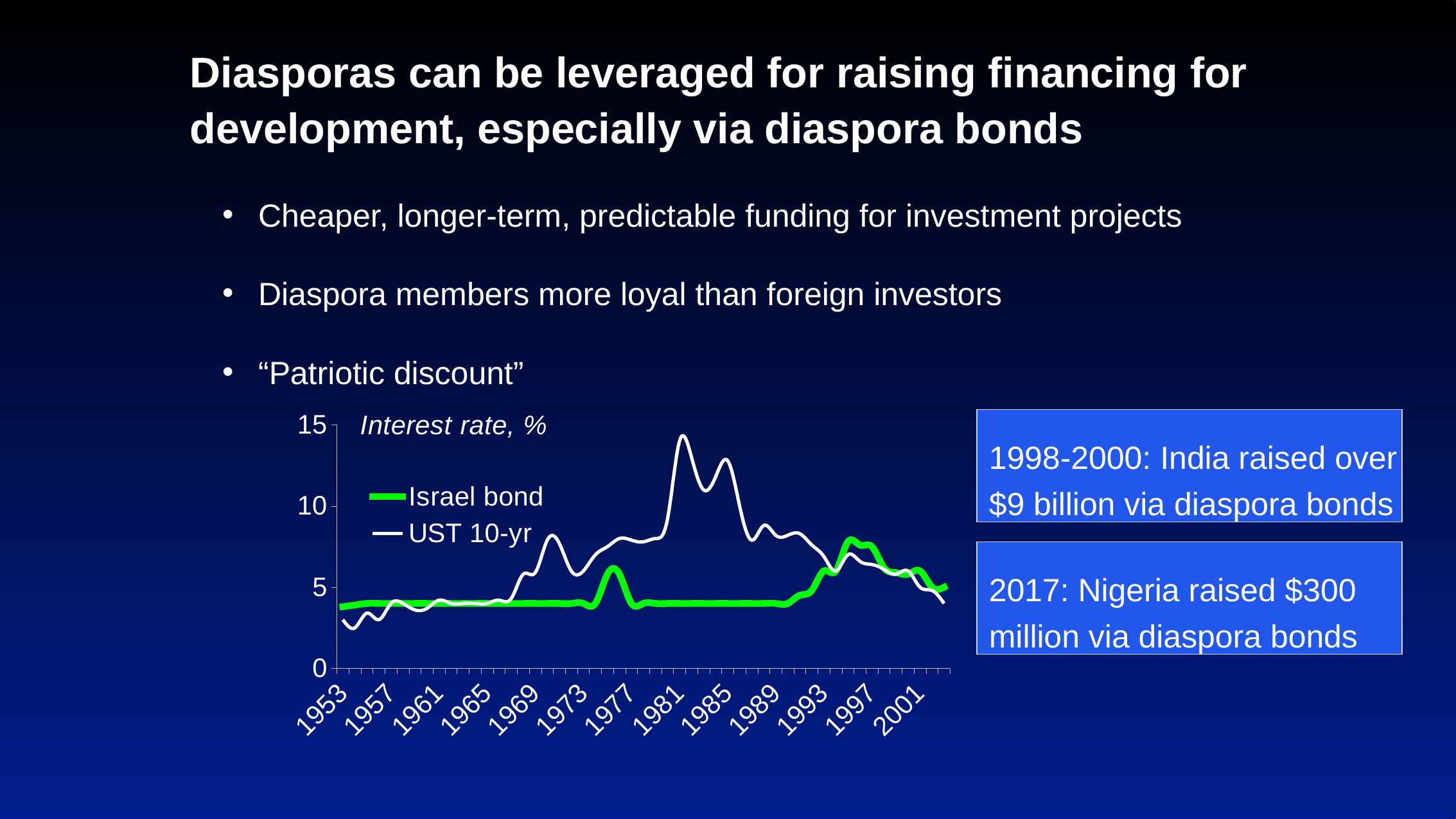
How many year labels are shown on the chart's x axis? 13 What kind of chart is shown on the slide? line chart What is the label on the chart's vertical axis? Interest rate, % How many series does the chart's legend list? 2 Is the Israel bond value around 1981 greater or less than 5? less Around 1985, which series has the higher interest rate, Israel bond or UST 10-yr? UST 10-yr Around 1981, which series has the higher interest rate, Israel bond or UST 10-yr? UST 10-yr Is the UST 10-yr value around 1981 greater or less than 10? greater Does the UST 10-yr series generally rise or fall between 1981 and 2001? fall Is the UST 10-yr value in 1953 greater or less than 5? less What are the two series named in the chart's legend? Israel bond and UST 10-yr